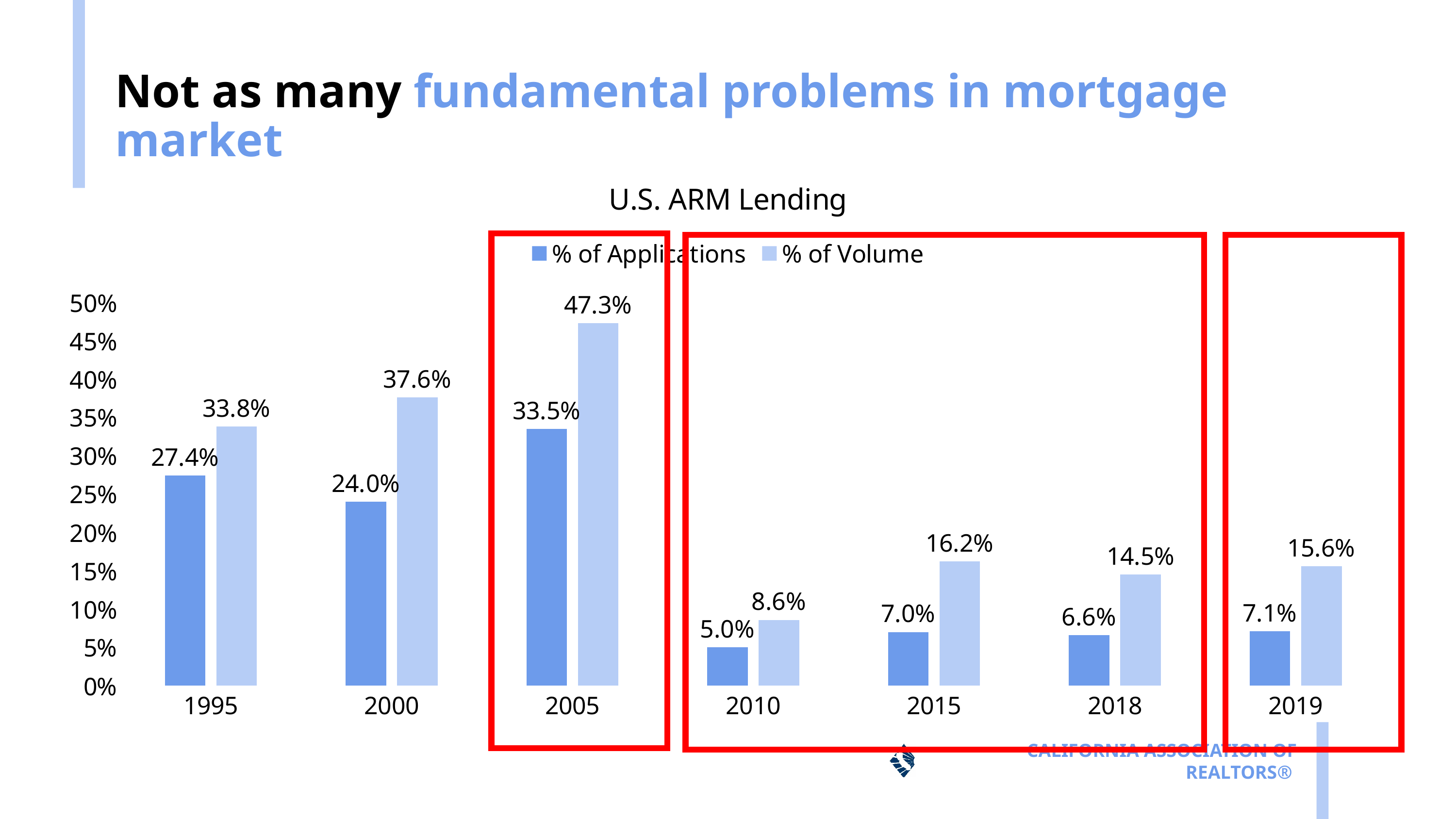
Which is larger: % of Applications in 1995 or % of Applications in 2000? 1995 Which year has the highest % of Volume? 2005 What is the % of Applications value for 2010? 5.0% What is the % of Volume value for 2019? 15.6% What kind of chart is shown? bar chart What is the difference between % of Volume and % of Applications in 2005? 13.8% How many years are shown on the x axis? 7 Which year has the lowest % of Applications? 2010 Is the % of Volume value for 2018 greater or less than 10%? greater How many series does the legend list? 2 What is the title of the chart? U.S. ARM Lending What is the % of Volume value for 2005? 47.3%